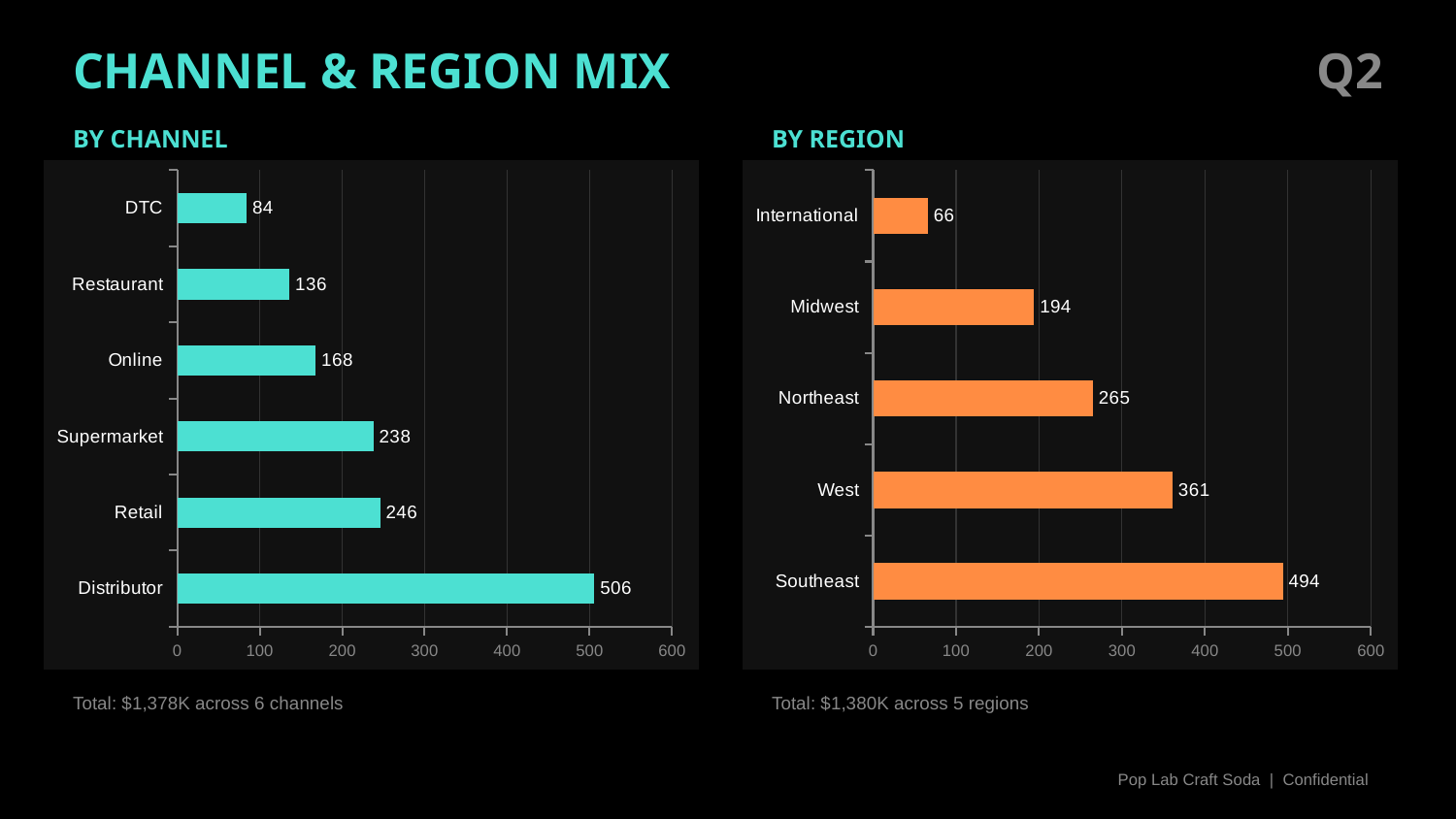
In the BY CHANNEL chart, which is larger, Online or Restaurant? Online How many regions are shown in the BY REGION chart? 5 What colour are the bars in the BY CHANNEL chart? Teal What kind of chart is the BY REGION chart? Bar chart In the BY REGION chart, which region has the lowest value? International In the BY REGION chart, is the value for Northeast greater or less than 200? greater In the BY CHANNEL chart, what is the difference between Distributor and Retail? 260 In the BY CHANNEL chart, which channel has the highest value? Distributor In the BY REGION chart, what is the value for Midwest? 194 How many channels are shown in the BY CHANNEL chart? 6 In the BY REGION chart, what is the difference between Southeast and West? 133 In the BY CHANNEL chart, what is the value for Supermarket? 238